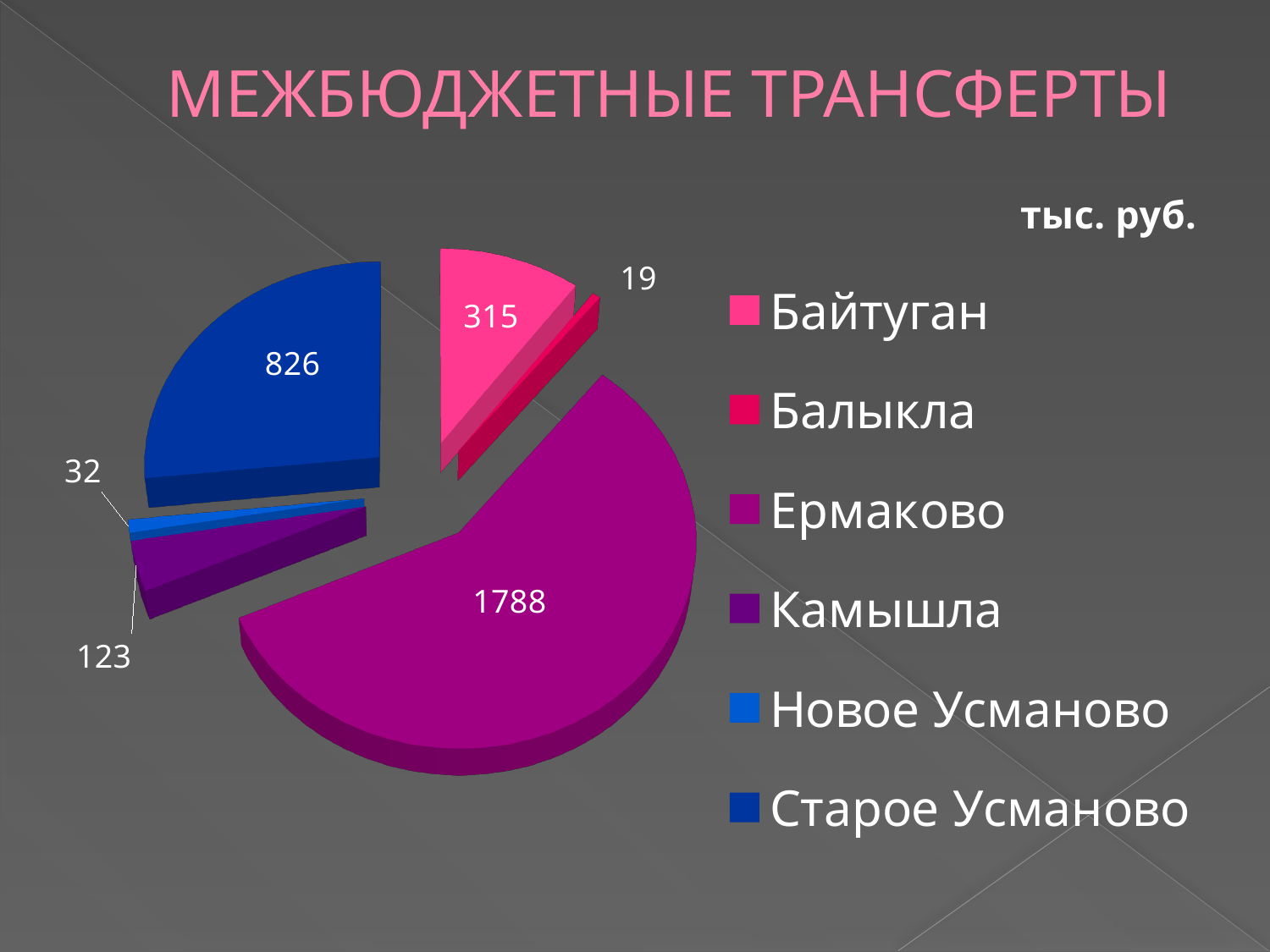
What is the difference between the values for Ермаково and Старое Усманово? 962 What is the value for Ермаково? 1788 What unit is indicated for the values in the chart? тыс. руб. What is the value for Камышла? 123 What is the value for Старое Усманово? 826 Which is larger, the value for Байтуган or the value for Камышла? Байтуган Which category has the smallest slice of the pie? Балыкла Which category has the largest slice of the pie? Ермаково What is the value for Новое Усманово? 32 What is the value for Байтуган? 315 How many categories does the pie chart show? 6 What type of chart is shown on the slide? Pie chart